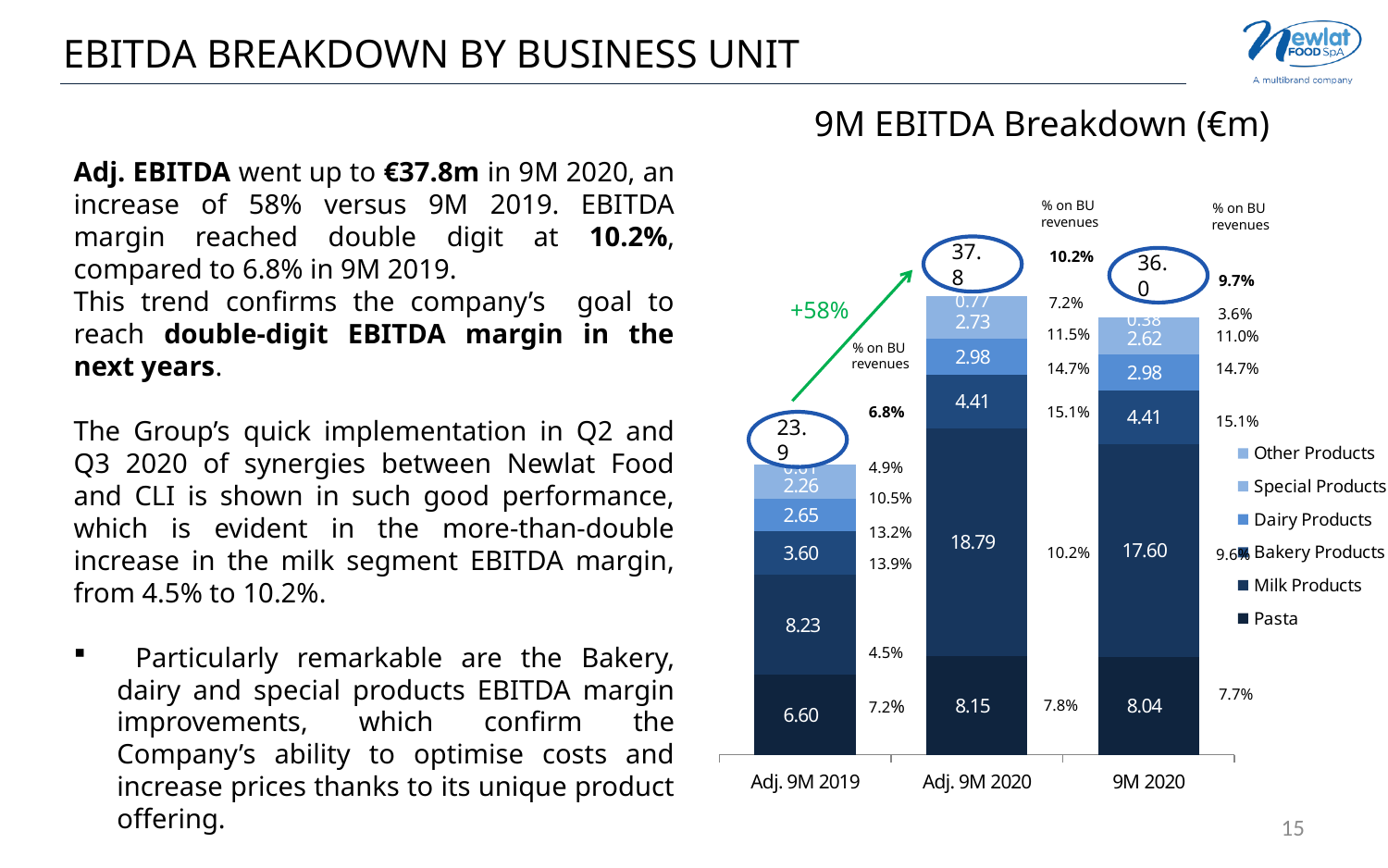
What is the Milk Products value for Adj. 9M 2020 in the 9M EBITDA Breakdown chart? 18.79 What percentage increase is annotated on the arrow between the Adj. 9M 2019 and Adj. 9M 2020 bars? +58% Which bar has the highest total in the 9M EBITDA Breakdown chart? Adj. 9M 2020 How many bars (periods) are shown in the 9M EBITDA Breakdown chart? 3 What is the total of the Adj. 9M 2020 bar in the 9M EBITDA Breakdown chart? 37.8 Which is larger in the 9M EBITDA Breakdown chart: the Pasta value for Adj. 9M 2020 or for 9M 2020? Adj. 9M 2020 What is the Pasta value for Adj. 9M 2019 in the 9M EBITDA Breakdown chart? 6.60 How many series does the legend of the 9M EBITDA Breakdown chart list? 6 What is the Dairy Products value for Adj. 9M 2019 in the 9M EBITDA Breakdown chart? 2.65 What is the Bakery Products value for 9M 2020 in the 9M EBITDA Breakdown chart? 4.41 What is the difference between the Milk Products values for Adj. 9M 2020 and 9M 2020 in the 9M EBITDA Breakdown chart? 1.19 What kind of chart is shown on the slide? Stacked bar chart